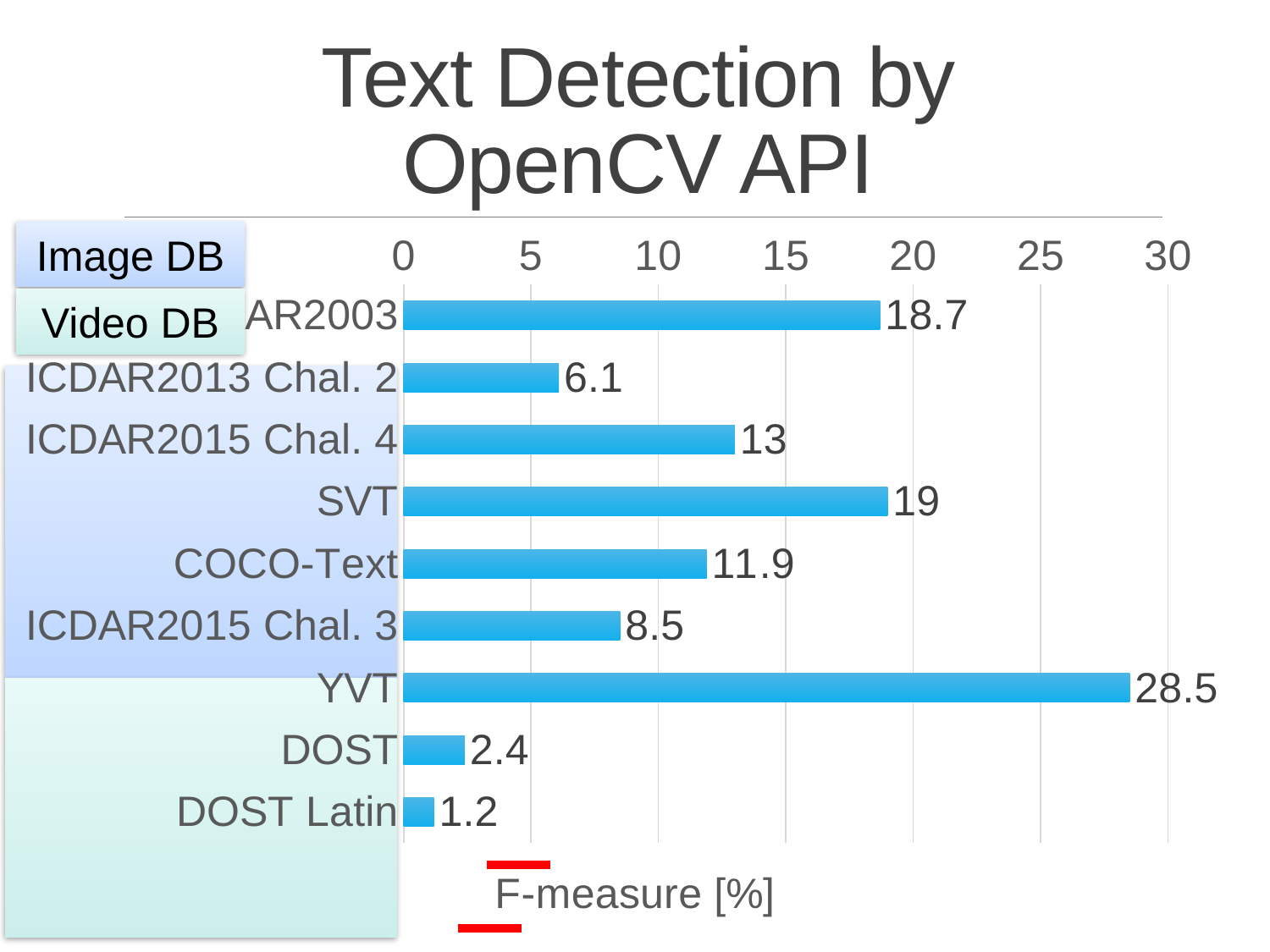
What is the F-measure for ICDAR2015 Chal. 3? 8.5 What is the label of the horizontal axis? F-measure [%] Which dataset has the highest F-measure? YVT What is the F-measure for YVT? 28.5 Which dataset has the lowest F-measure? DOST Latin What is the F-measure for COCO-Text? 11.9 What kind of chart is shown on the slide? Bar chart How many datasets are shown in the chart? 9 What is the F-measure for SVT? 19 Which has a larger F-measure, ICDAR2015 Chal. 4 or ICDAR2013 Chal. 2? ICDAR2015 Chal. 4 What is the difference between the F-measure for YVT and the F-measure for SVT? 9.5 What is the F-measure for DOST Latin? 1.2